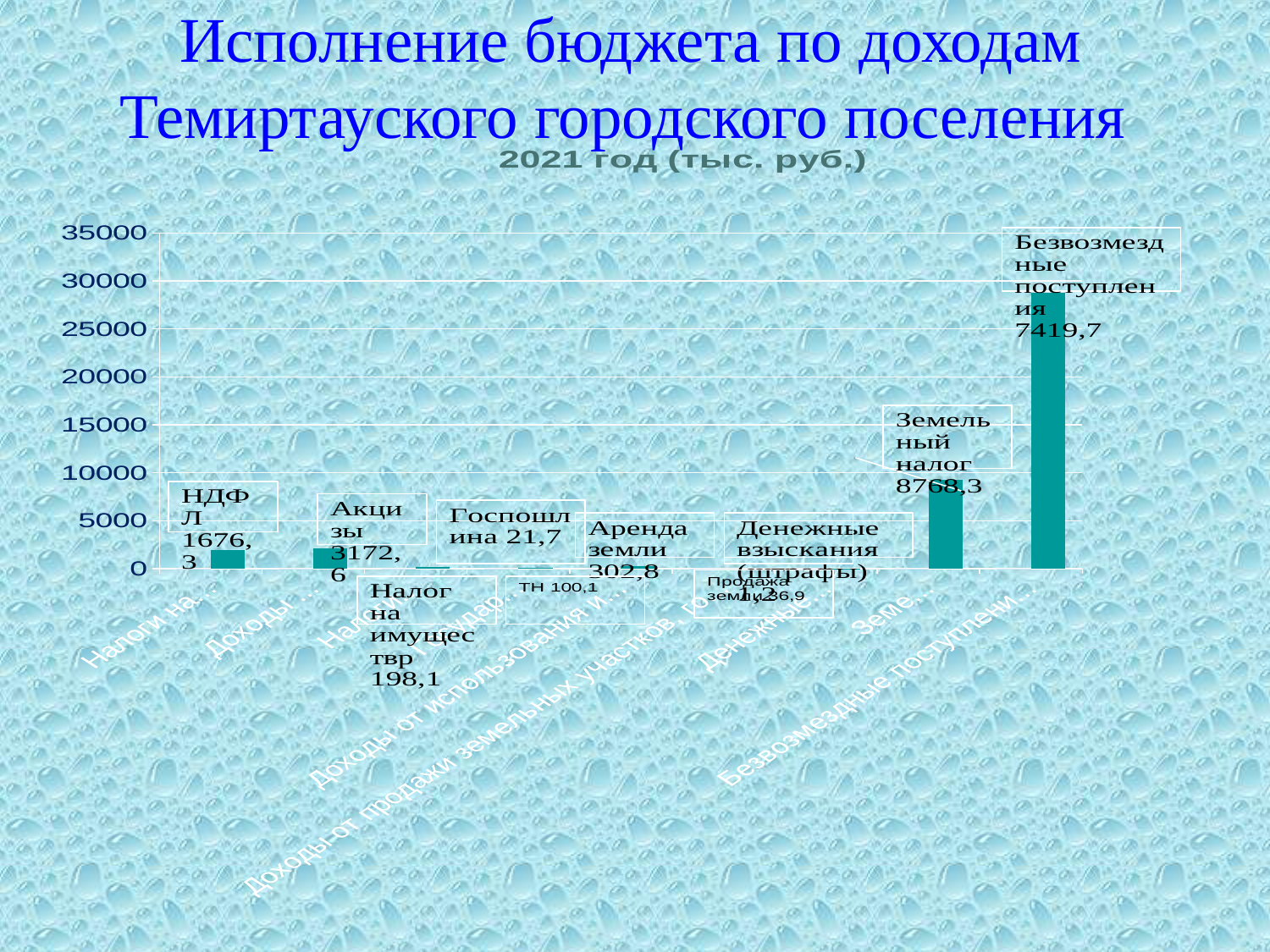
What is the value shown for Госпошлина? 21,7 What is the difference between Акцизы and НДФЛ? 1496,3 What is the value shown for Аренда земли? 302,8 What is the value shown for НДФЛ? 1676,3 Is the value for Земельный налог greater or less than 5000? greater What is the value shown for Налог на имущество? 198,1 What is the value shown for Акцизы? 3172,6 What is the title of the chart? 2021 год (тыс. руб.) What is the value shown for Земельный налог? 8768,3 Which is larger, Акцизы or НДФЛ? Акцизы What kind of chart is shown on the slide? bar chart Which category has the tallest bar? Безвозмездные поступления